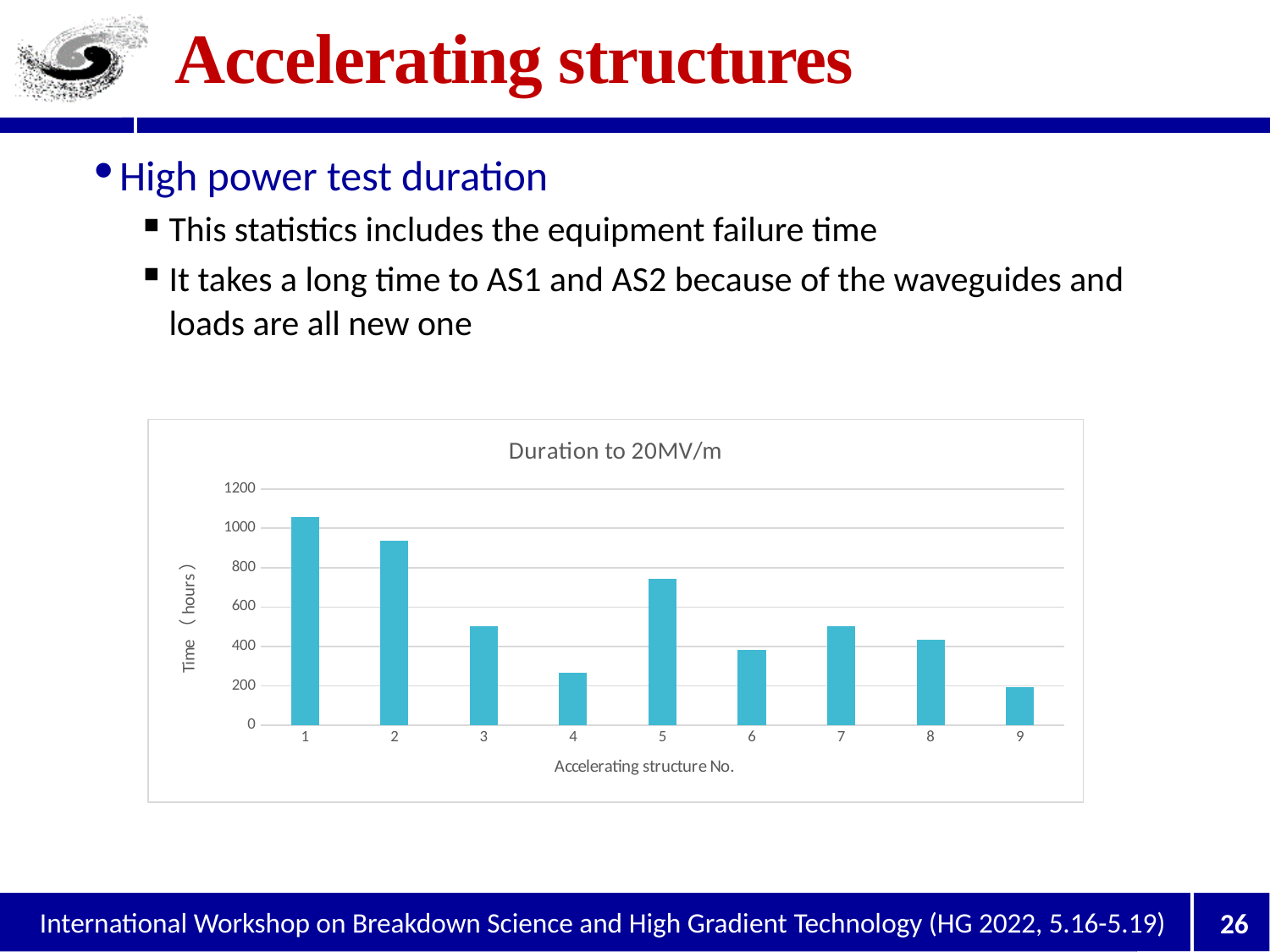
Is the value for accelerating structure 5 greater or less than 800? less How many accelerating structures are plotted in the chart? 9 Which has a longer duration, accelerating structure 5 or accelerating structure 6? 5 Which accelerating structure has the highest duration to 20MV/m? 1 What type of chart is shown on the slide? bar chart What is the title of the chart? Duration to 20MV/m Which has a longer duration, accelerating structure 1 or accelerating structure 2? 1 Is the value for accelerating structure 3 greater or less than 400? greater Do the values rise or fall from accelerating structure 1 to accelerating structure 4? fall What is the label of the vertical axis of the chart? Time (hours) Is the value for accelerating structure 2 greater or less than 1000? less Which accelerating structure has the lowest duration to 20MV/m? 9